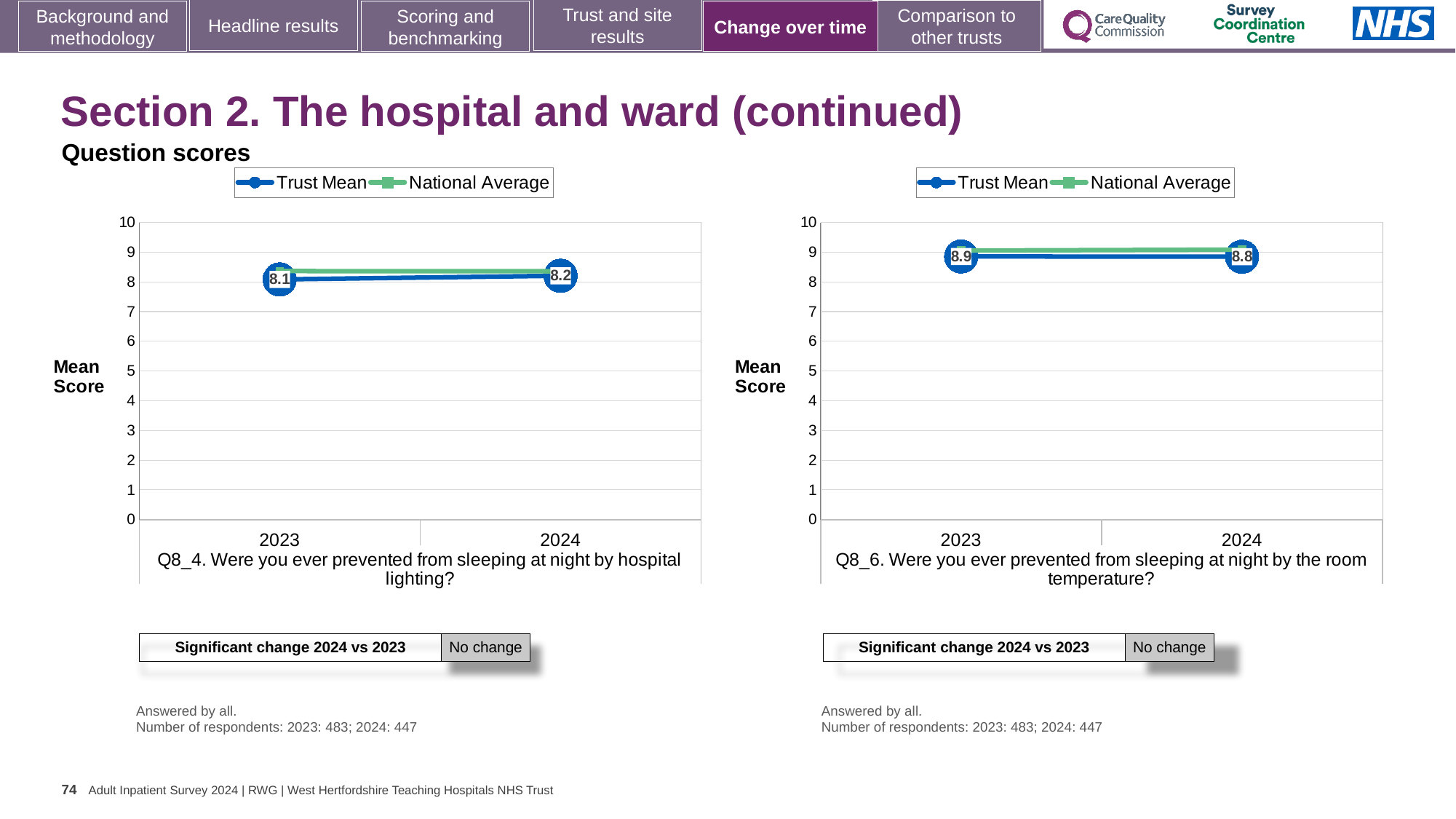
In the Q8_6 room temperature chart, which year has the higher Trust Mean score, 2023 or 2024? 2023 In the Q8_4 hospital lighting chart, what is the Trust Mean score for 2023? 8.1 In the Q8_6 room temperature chart, what is the Trust Mean score for 2023? 8.9 In the Q8_4 hospital lighting chart, is the National Average for 2023 greater or less than 8? greater How many years are plotted on the x axis of the Q8_4 hospital lighting chart? 2 In the Q8_4 hospital lighting chart, does the Trust Mean rise or fall from 2023 to 2024? rise In the Q8_4 hospital lighting chart, what is the difference between the Trust Mean scores for 2024 and 2023? 0.1 In the Q8_6 room temperature chart, does the Trust Mean rise or fall from 2023 to 2024? fall How many series does the legend of the Q8_6 room temperature chart list? 2 In the Q8_6 room temperature chart, what is the Trust Mean score for 2024? 8.8 In the Q8_4 hospital lighting chart, what is the Trust Mean score for 2024? 8.2 What kind of chart is the Q8_6 room temperature chart? line chart